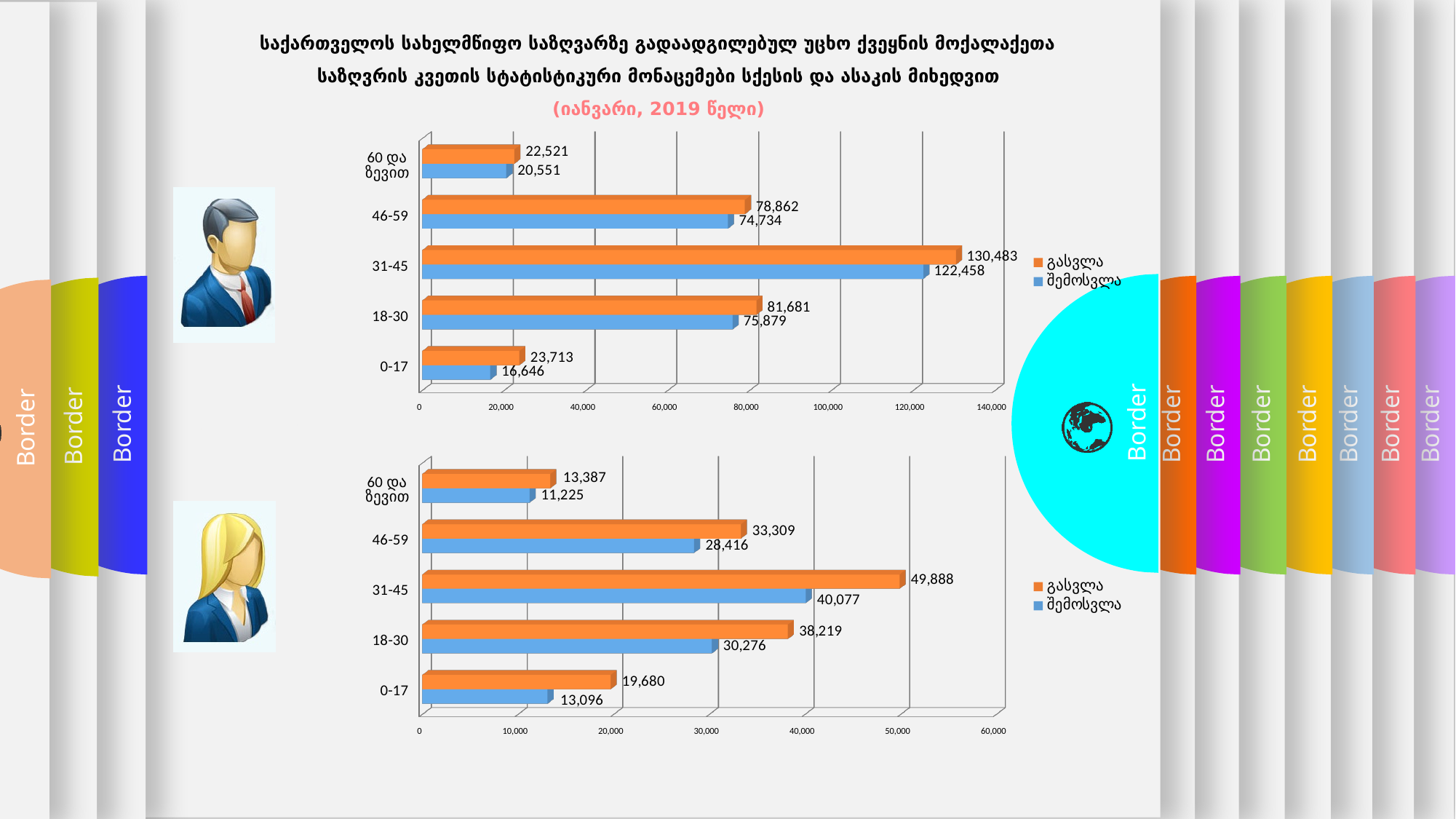
In the top chart, what is the გასვლა value for the 31-45 age group? 130,483 In the top chart, what is the შემოსვლა value for the 0-17 age group? 16,646 In the top chart, which is larger for the 18-30 age group: გასვლა or შემოსვლა? გასვლა How many series does the legend of the top chart list? 2 In the bottom chart, what is the difference between the გასვლა and შემოსვლა values for the 31-45 age group? 9,811 In the top chart, which age group has the highest გასვლა value? 31-45 In the bottom chart, which age group has the lowest შემოსვლა value? 60 და ზევით In the top chart, what is the difference between the გასვლა and შემოსვლა values for the 46-59 age group? 4,128 In the bottom chart, what is the გასვლა value for the 18-30 age group? 38,219 In the bottom chart, what is the შემოსვლა value for the 46-59 age group? 28,416 What type of chart is the bottom chart? Bar chart How many age groups are shown in the bottom chart? 5